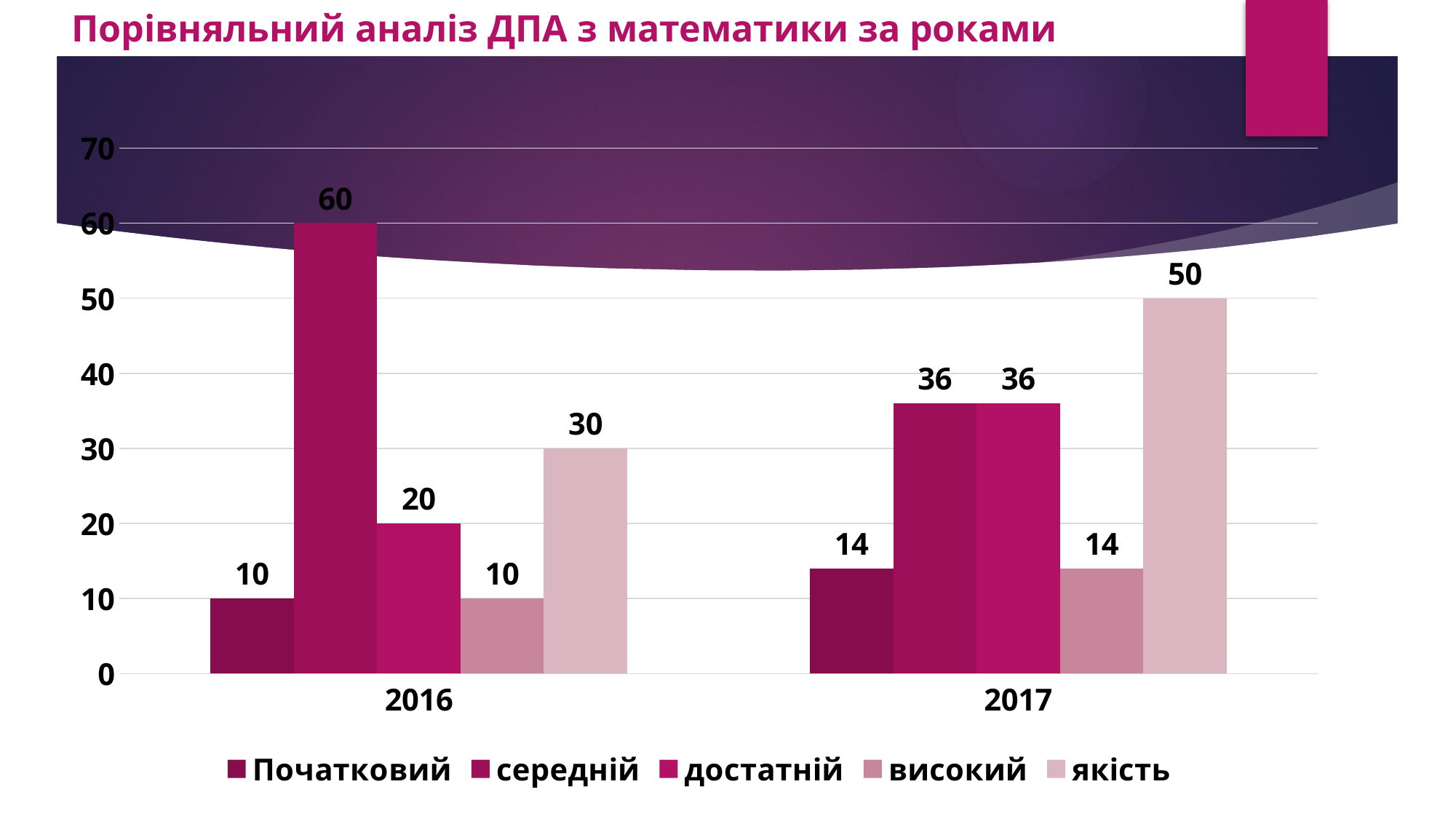
What type of chart is shown on the slide? bar chart How many year categories are shown on the x axis? 2 What is the difference between the якість values for 2017 and 2016? 20 What is the title of the chart? Порівняльний аналіз ДПА з математики за роками Which series has the highest value in 2017? якість What is the value for середній in 2016? 60 What is the value for достатній in 2016? 20 Which is larger: середній in 2016 or середній in 2017? середній in 2016 Which series has the highest value in 2016? середній How many series does the legend list? 5 What is the value for Початковий in 2017? 14 What is the value for якість in 2017? 50